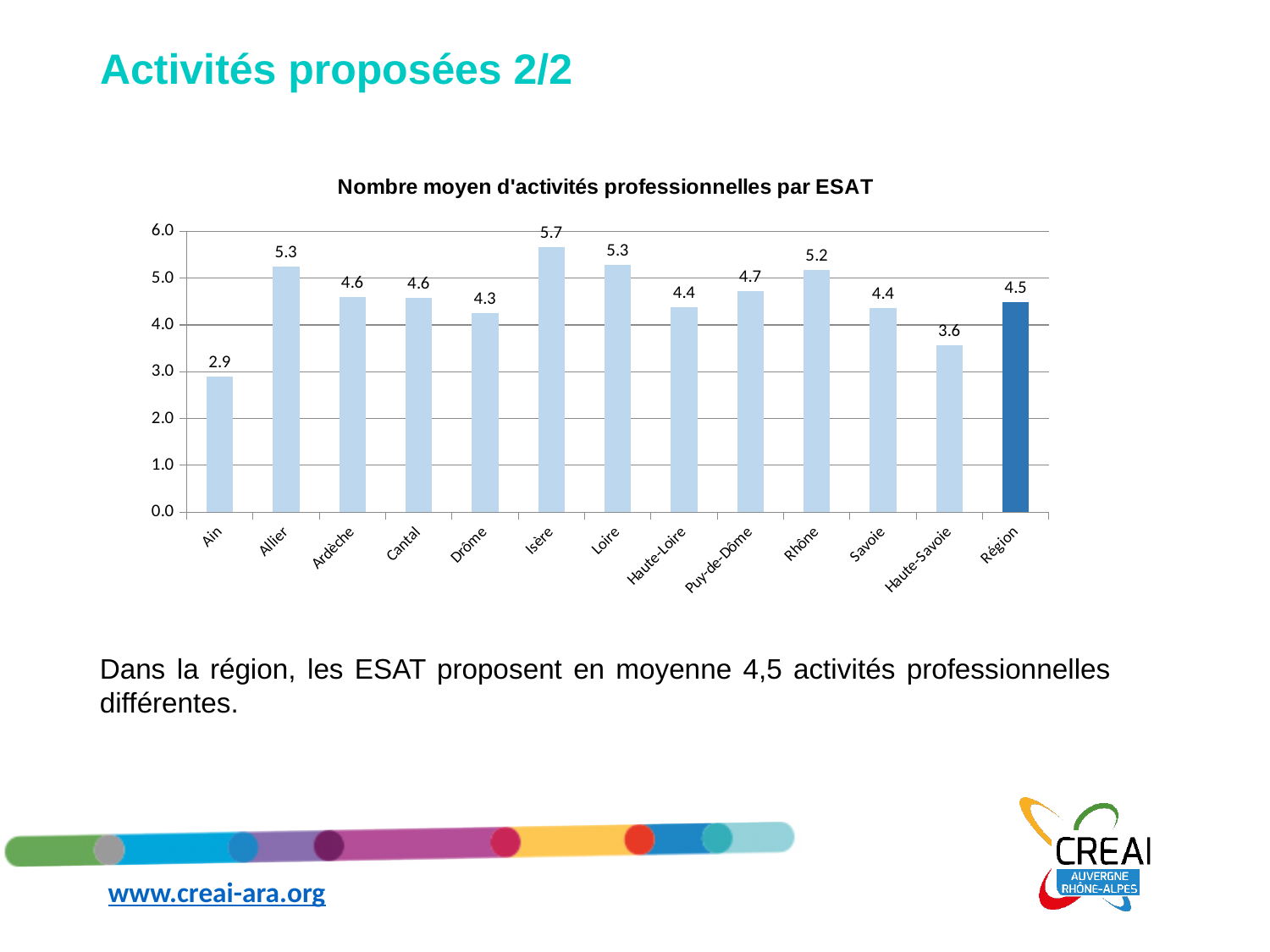
What is the value for Ain? 2.9 What is the value for Isère? 5.7 Which is larger, the value for Rhône or the value for Savoie? Rhône What is the title of the chart? Nombre moyen d'activités professionnelles par ESAT Which category has the highest value? Isère What is the difference between the values for Isère and Ain? 2.8 What is the value for Région? 4.5 What kind of chart is shown? bar chart How many categories are shown on the x axis? 13 Which category has the lowest value? Ain Is the value for Puy-de-Dôme greater or less than 4.0? greater What is the value for Haute-Savoie? 3.6